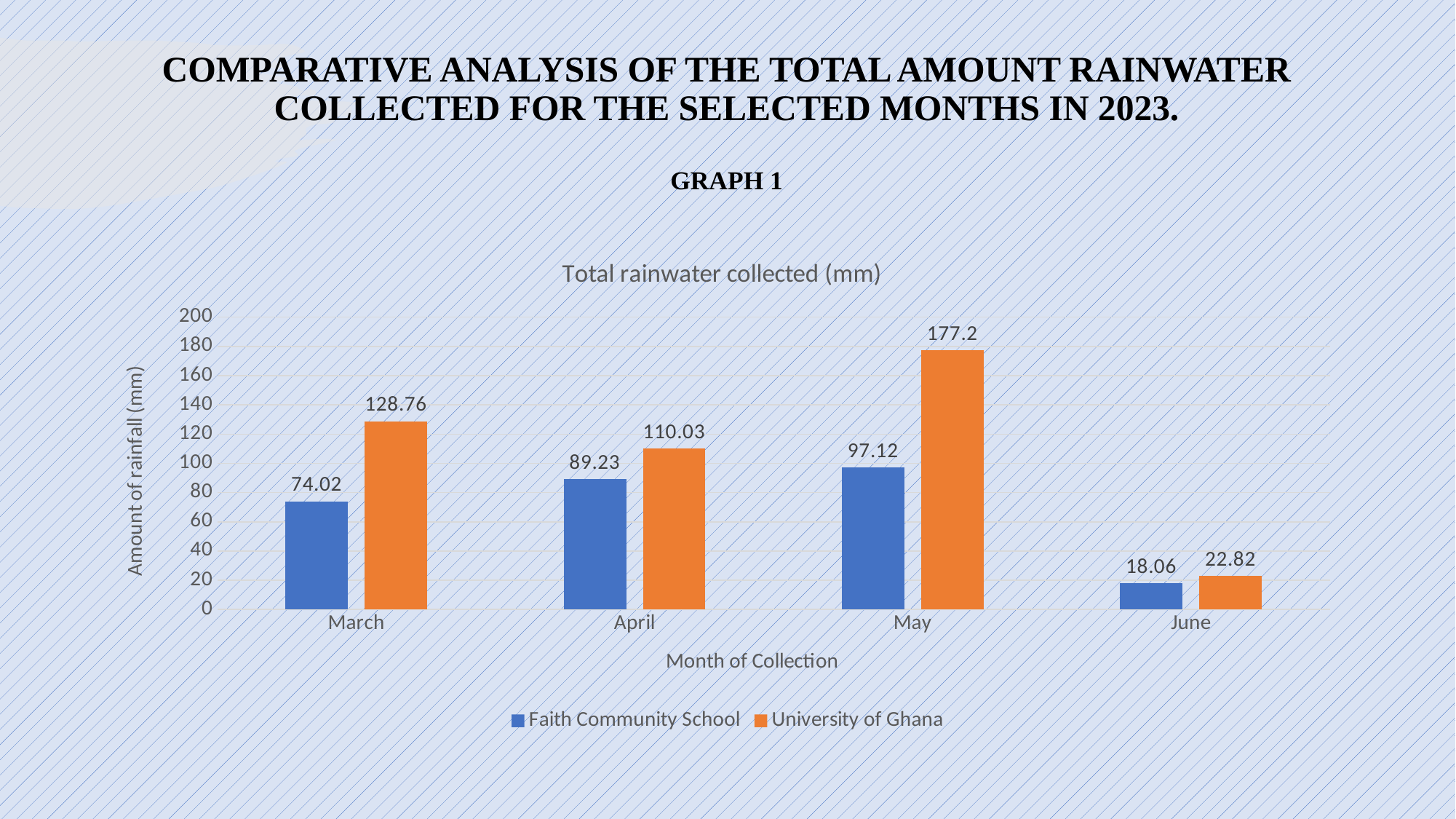
What is the value for University of Ghana in May? 177.2 How many series does the legend list? 2 Which is larger in April: Faith Community School or University of Ghana? University of Ghana In which month is the Faith Community School value lowest? June What kind of chart is shown? Bar chart What is the value for Faith Community School in March? 74.02 What is the difference between the University of Ghana and Faith Community School values in May? 80.08 What is the title of the chart? Total rainwater collected (mm) Is the value for University of Ghana in March greater or less than 120? greater In which month is the University of Ghana value highest? May How many months are shown on the x axis? 4 What is the value for University of Ghana in June? 22.82